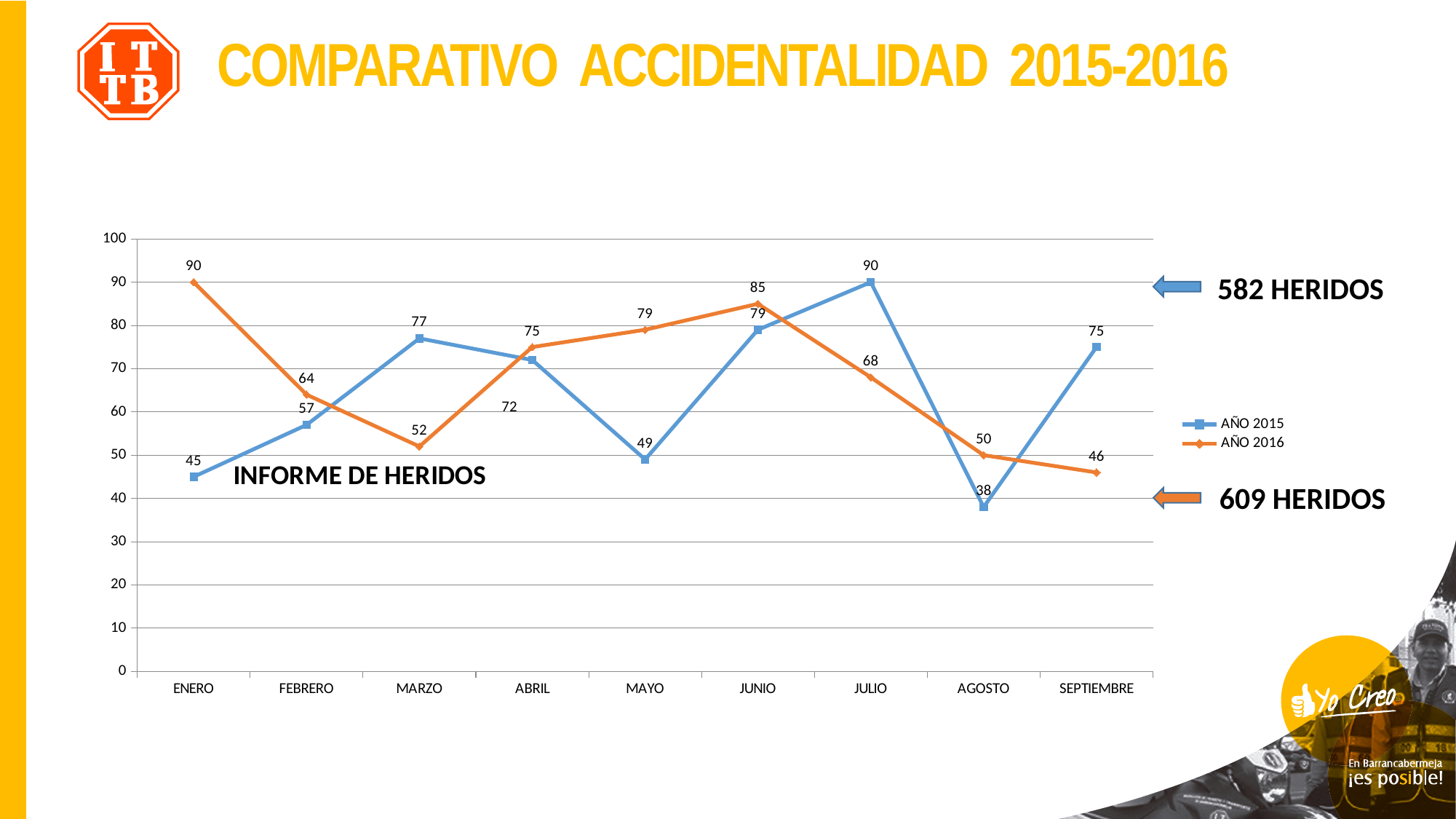
What is the value for AÑO 2016 in SEPTIEMBRE? 46 What is the value for AÑO 2015 in JULIO? 90 What is the difference between the AÑO 2016 and AÑO 2015 values in ENERO? 45 What is the value for AÑO 2016 in ENERO? 90 Which colour is used for the AÑO 2016 line? orange How many series does the legend list? 2 How many months are shown on the x axis? 9 In which month is the AÑO 2015 value lowest? AGOSTO What type of chart is shown on the slide? line chart In which month is the AÑO 2016 value highest? ENERO Does the AÑO 2016 line rise or fall from JUNIO to SEPTIEMBRE? fall Which series has the larger value in MARZO, AÑO 2015 or AÑO 2016? AÑO 2015